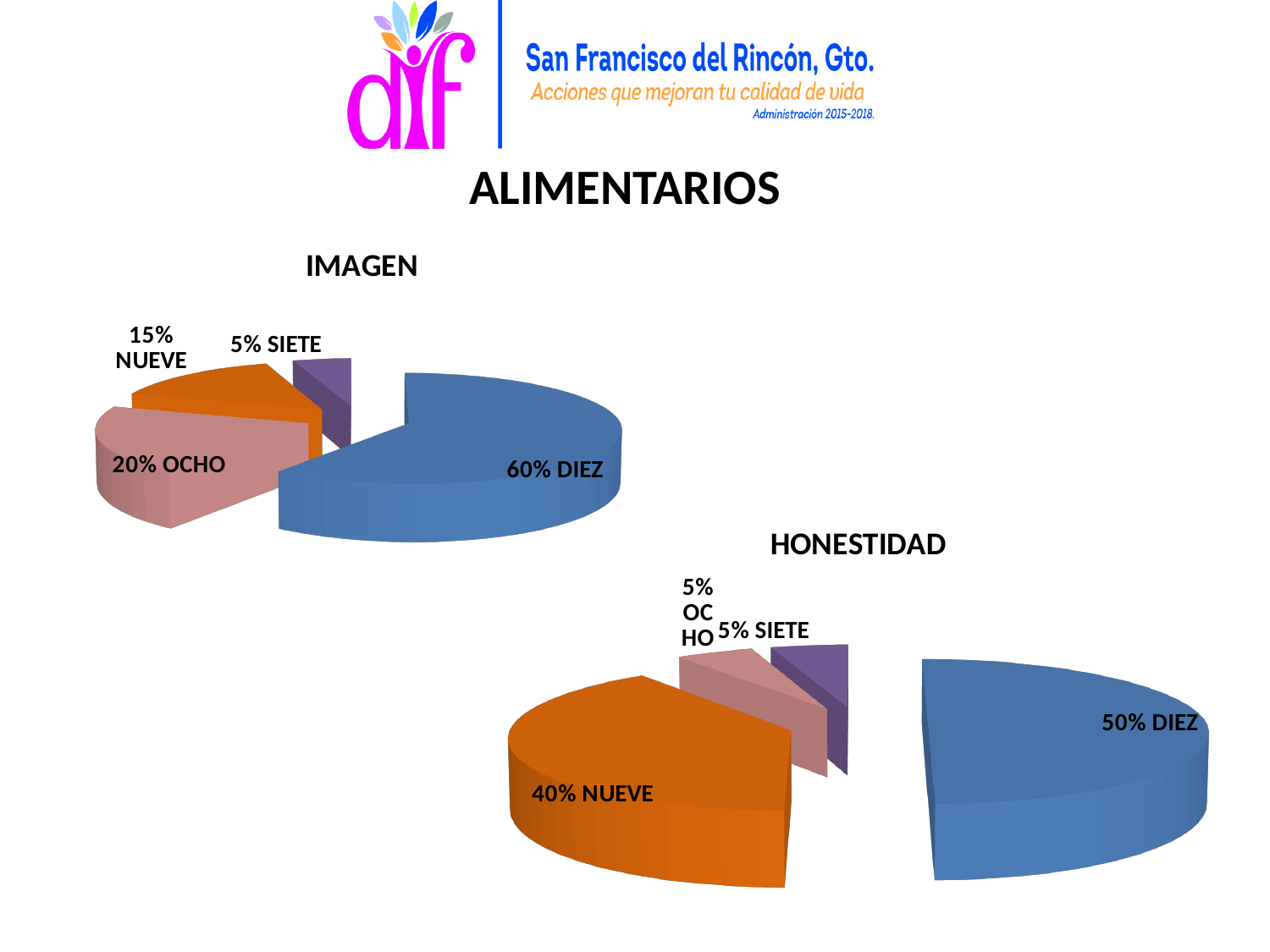
In the IMAGEN chart, what share does DIEZ have? 60% In the HONESTIDAD chart, which category has the largest slice? DIEZ In the IMAGEN chart, which category has the largest slice? DIEZ In the HONESTIDAD chart, what is the difference between the shares of DIEZ and NUEVE? 10% In the HONESTIDAD chart, what share does NUEVE have? 40% In the HONESTIDAD chart, what share does DIEZ have? 50% In the IMAGEN chart, which category has the smallest slice? SIETE In the IMAGEN chart, which is larger, the share of NUEVE or the share of OCHO? OCHO In the IMAGEN chart, how many slices are there? 4 In the IMAGEN chart, what is the difference between the shares of DIEZ and OCHO? 40% What kind of chart is the HONESTIDAD chart? Pie chart